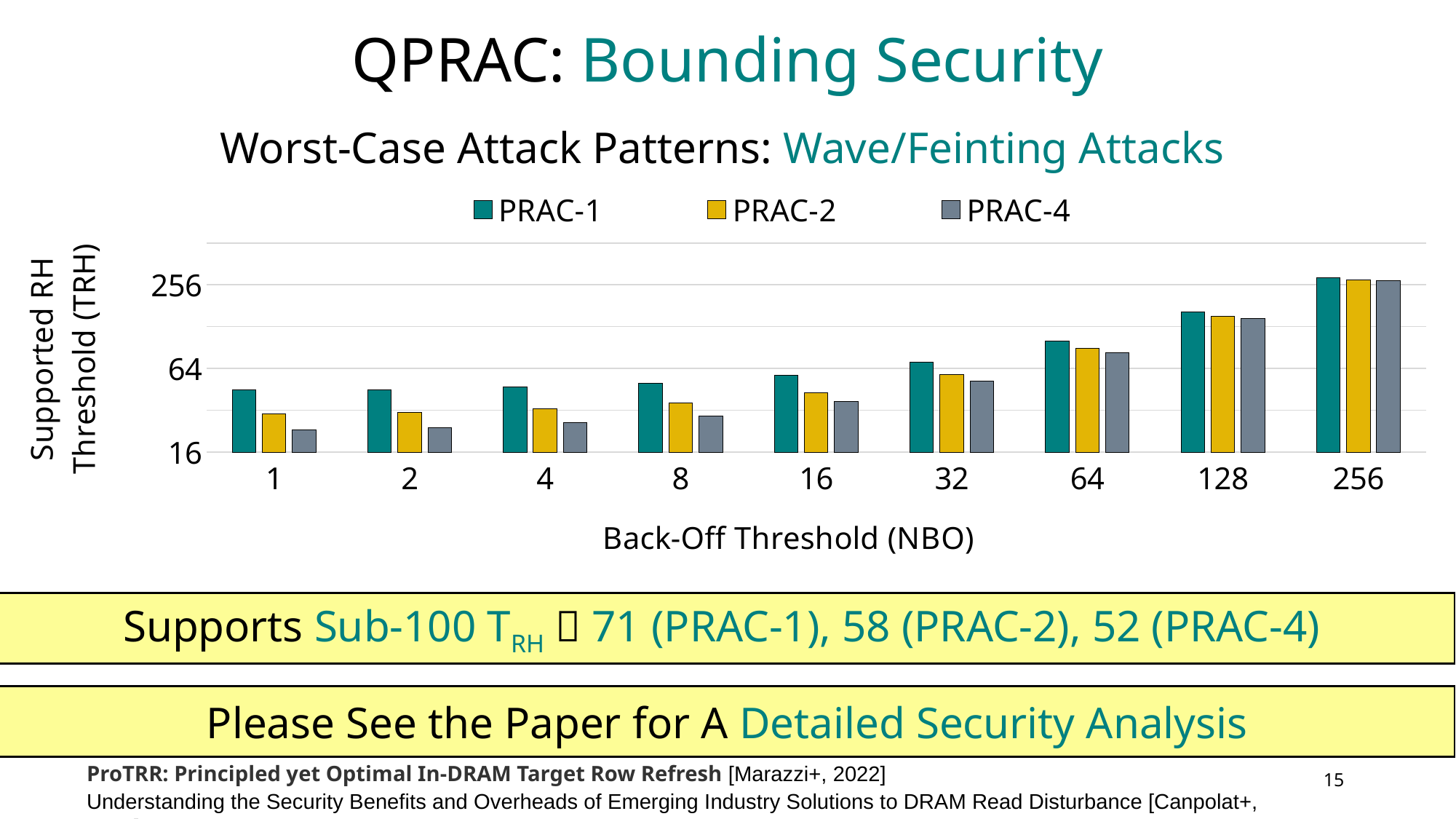
How many Back-Off Threshold (NBO) categories are shown on the x axis? 9 What kind of chart is shown on the slide? bar chart Is the PRAC-4 value at NBO 1 greater or less than 16? greater What is the title of the chart's x axis? Back-Off Threshold (NBO) Is the PRAC-1 value at NBO 1 greater or less than 64? less Which series is shown in teal in the chart legend? PRAC-1 How many series does the chart legend list? 3 Is the PRAC-1 value at NBO 128 greater or less than 256? less At which Back-Off Threshold (NBO) is the PRAC-1 value highest? 256 At NBO 1, which is larger: the PRAC-1 value or the PRAC-4 value? PRAC-1 Do the PRAC-1 values rise or fall as the Back-Off Threshold (NBO) increases along the x axis? rise